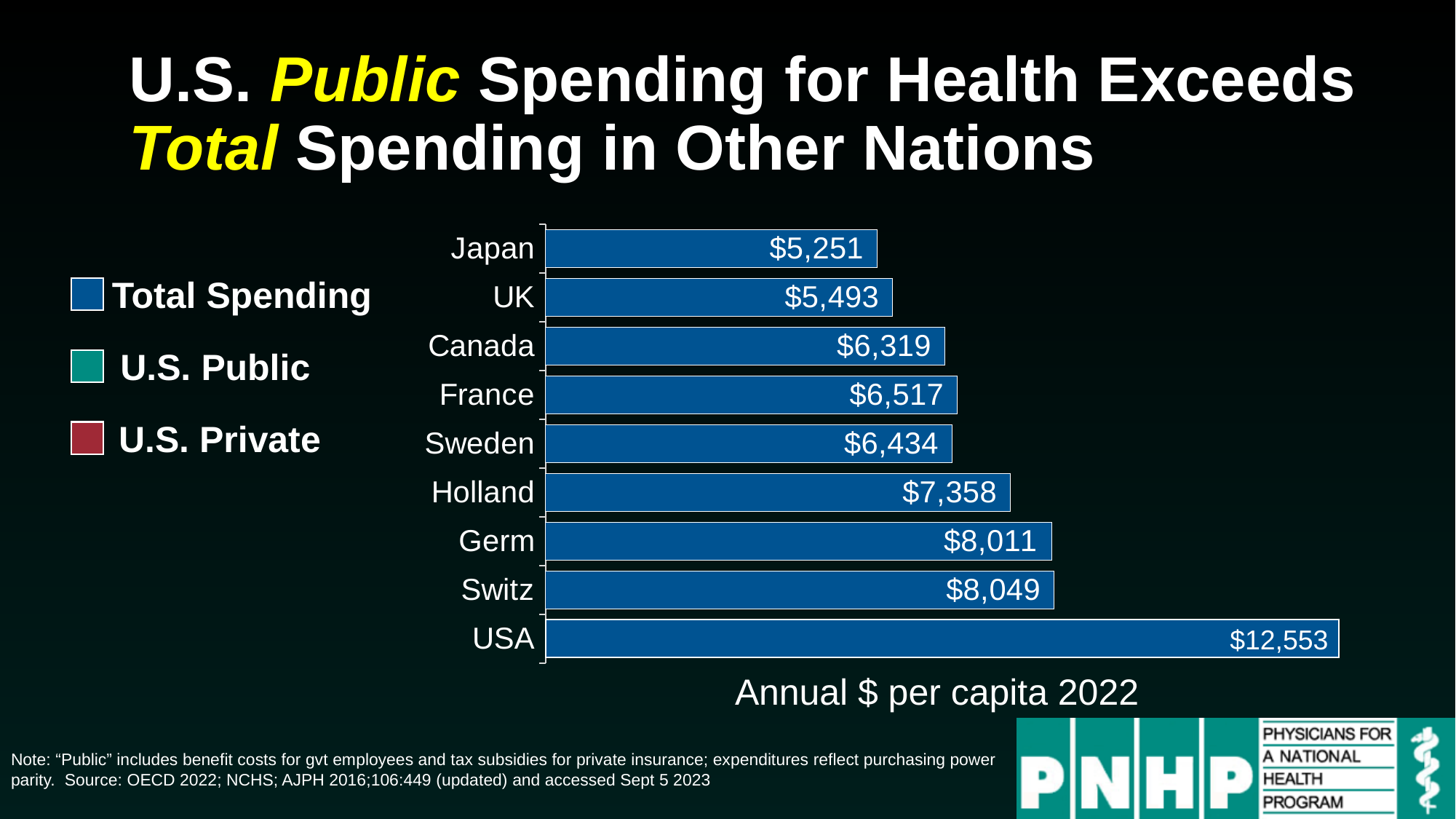
Which has a larger value, Canada or the UK? Canada What is the total health spending per capita shown for Japan? $5,251 How many entries does the legend list? 3 What is the difference between the France and Sweden values? $83 How much larger is the USA value than the Switz value? $4,504 How many countries are shown in the chart? 9 What kind of chart is shown on the slide? Bar chart What value is shown for Canada? $6,319 Which country has the highest value in the chart? USA What is the value shown for the USA bar? $12,553 What value is shown for Holland? $7,358 Which country has the lowest value in the chart? Japan